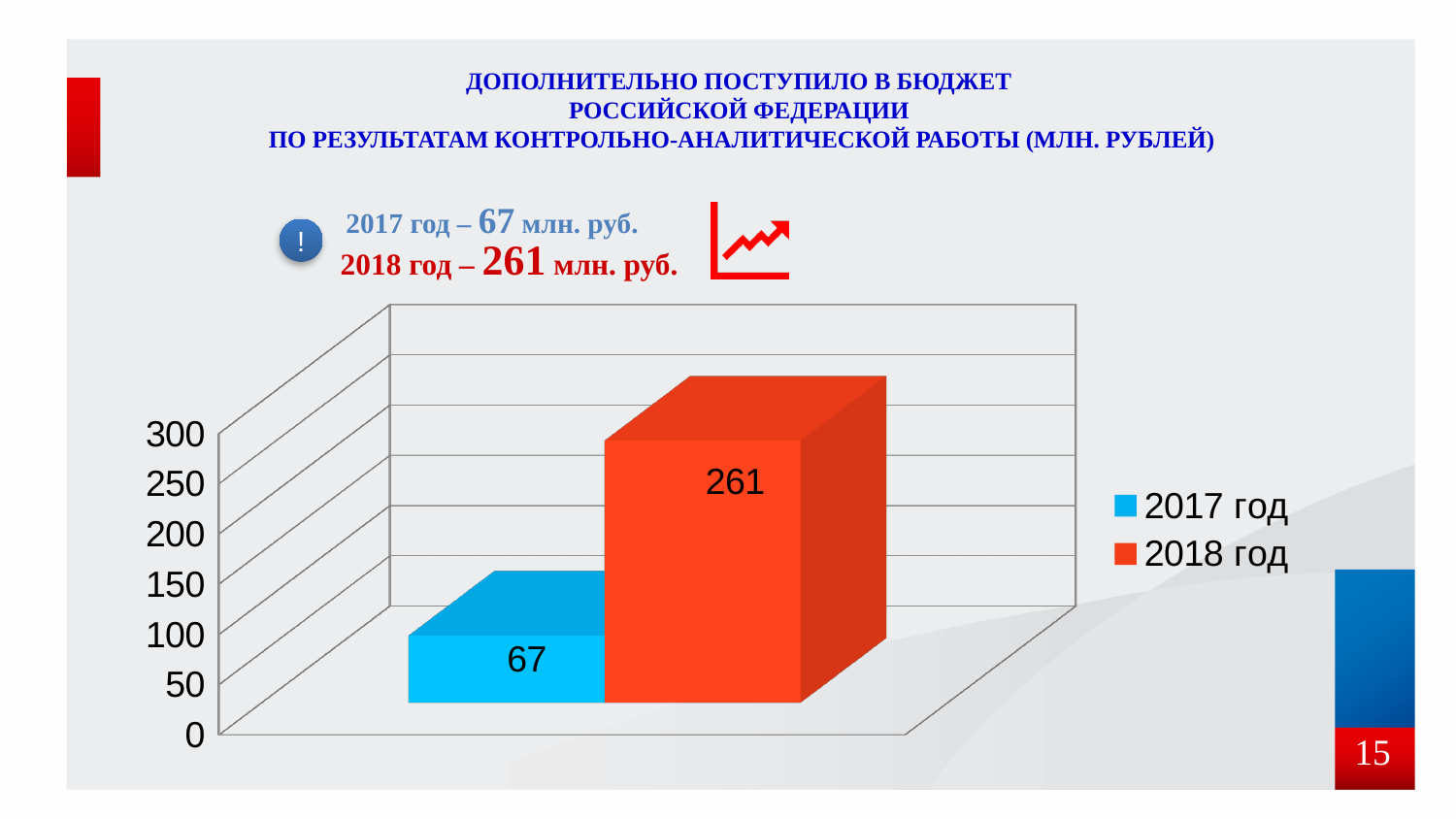
Is the value for 2018 год larger or smaller than the value for 2017 год? larger What is the difference between the values for 2018 год and 2017 год? 194 Is the value for 2017 год greater or less than 100? less How many series does the legend list? 2 What is the value for 2017 год? 67 What colour is the bar for 2018 год? red Do the values rise or fall from 2017 год to 2018 год? rise Which year has the lower value? 2017 год Which year has the higher value? 2018 год What kind of chart is shown on the slide? bar chart Is the value for 2018 год greater or less than 250? greater What is the value for 2018 год? 261